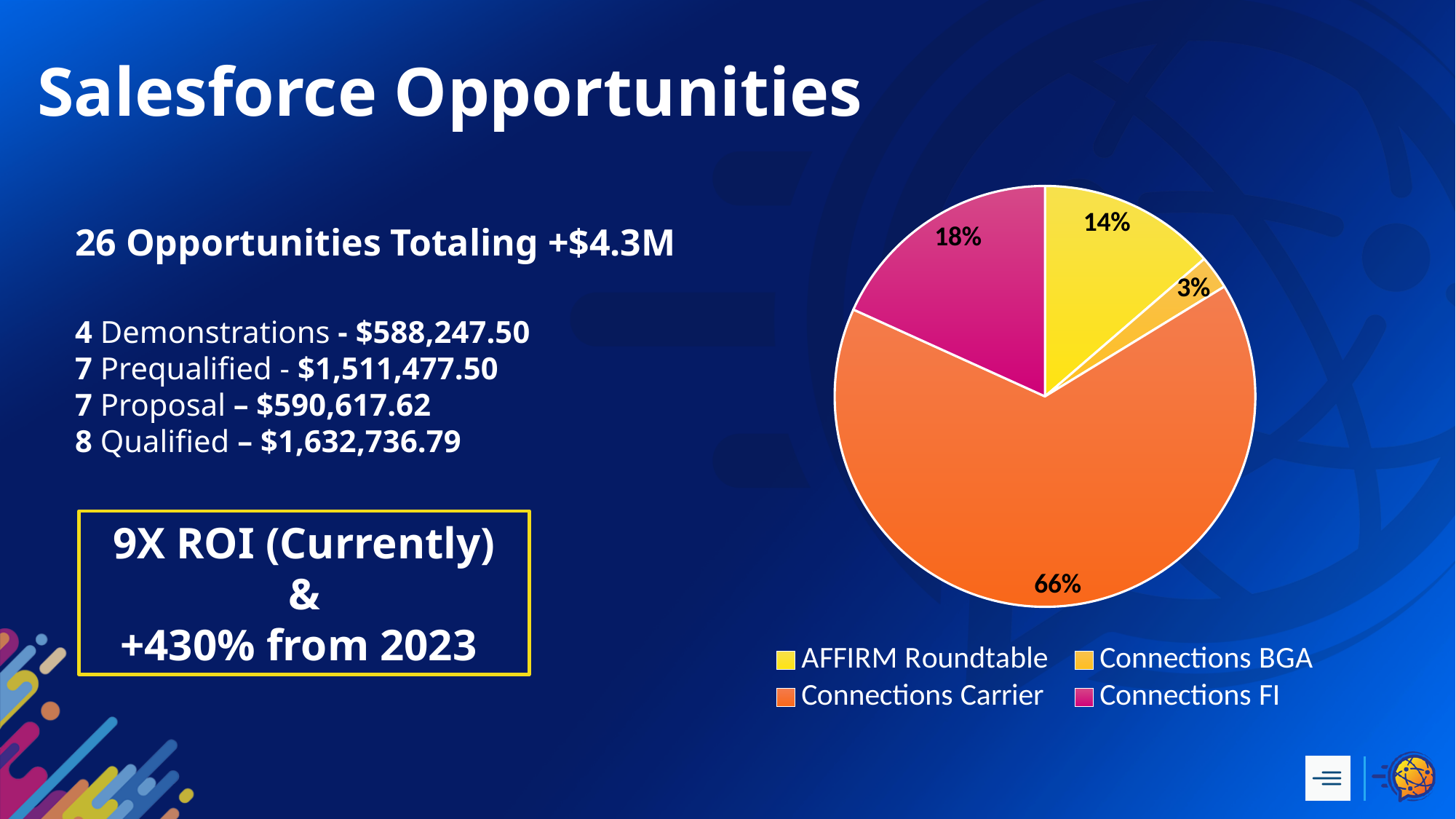
What is the difference in percentage points between Connections Carrier and Connections FI? 48 What share of the pie does AFFIRM Roundtable represent? 14% How many entries does the legend of the pie chart list? 4 What share of the pie does Connections FI represent? 18% What share of the pie does Connections Carrier represent? 66% What kind of chart is shown on the slide? pie chart Which is larger, the share for Connections FI or the share for AFFIRM Roundtable? Connections FI What share of the pie does Connections BGA represent? 3% Which category has the smallest slice of the pie? Connections BGA What colour is the Connections FI slice in the pie chart? magenta/pink How many categories does the pie chart show? 4 Which category has the largest slice of the pie? Connections Carrier